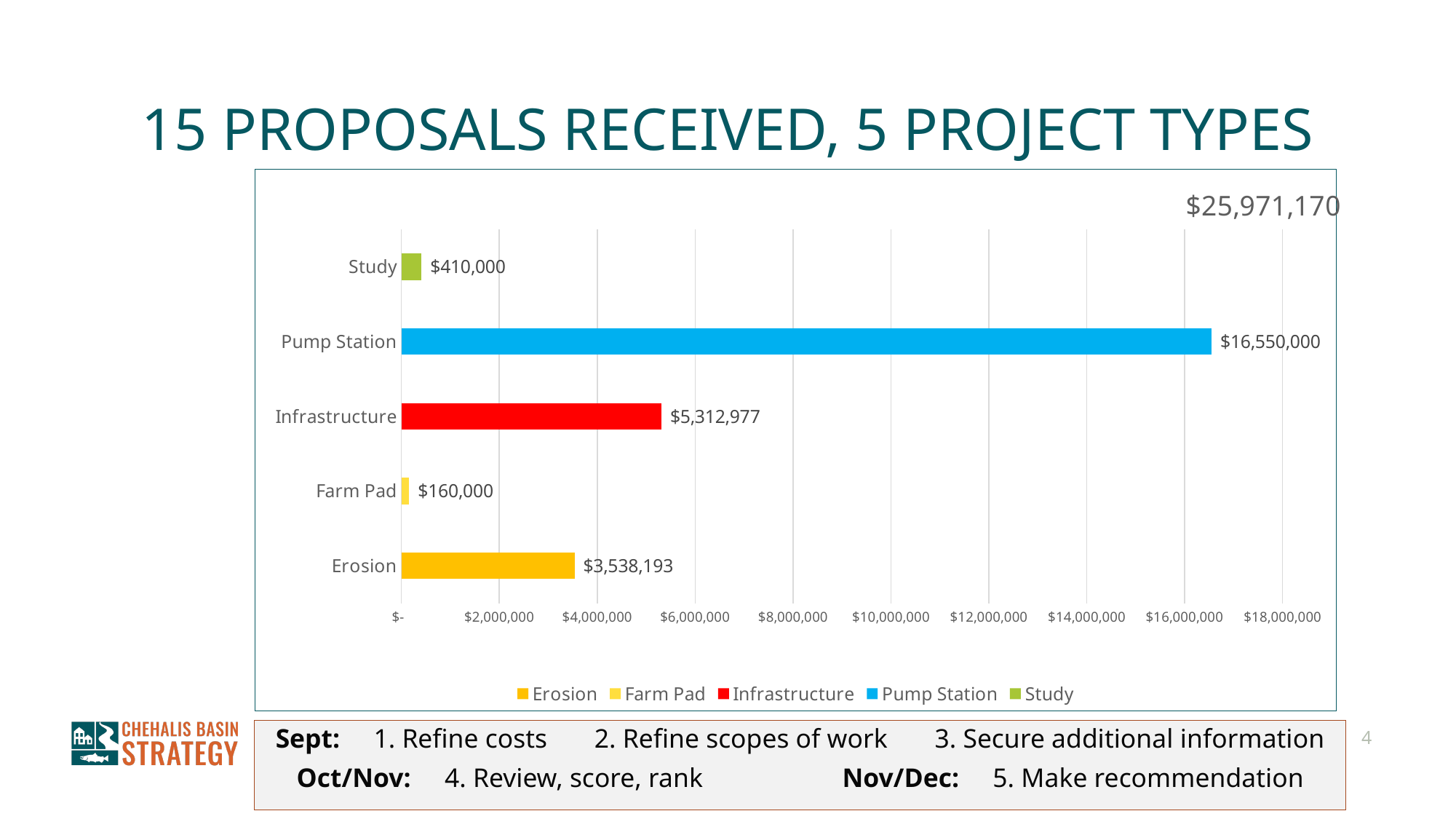
What is the value for Erosion? $3,538,193 What total amount is printed at the top right of the chart? $25,971,170 What is the difference between the Pump Station and Infrastructure values? $11,237,023 What is the value for Farm Pad? $160,000 Which project type has the highest value? Pump Station What is the value for Pump Station? $16,550,000 What is the value for Infrastructure? $5,312,977 What kind of chart is shown on the slide? Bar chart Which is larger, the value for Erosion or the value for Infrastructure? Infrastructure How many project types are shown in the chart? 5 Which project type has the lowest value? Farm Pad What is the difference between the Study and Farm Pad values? $250,000